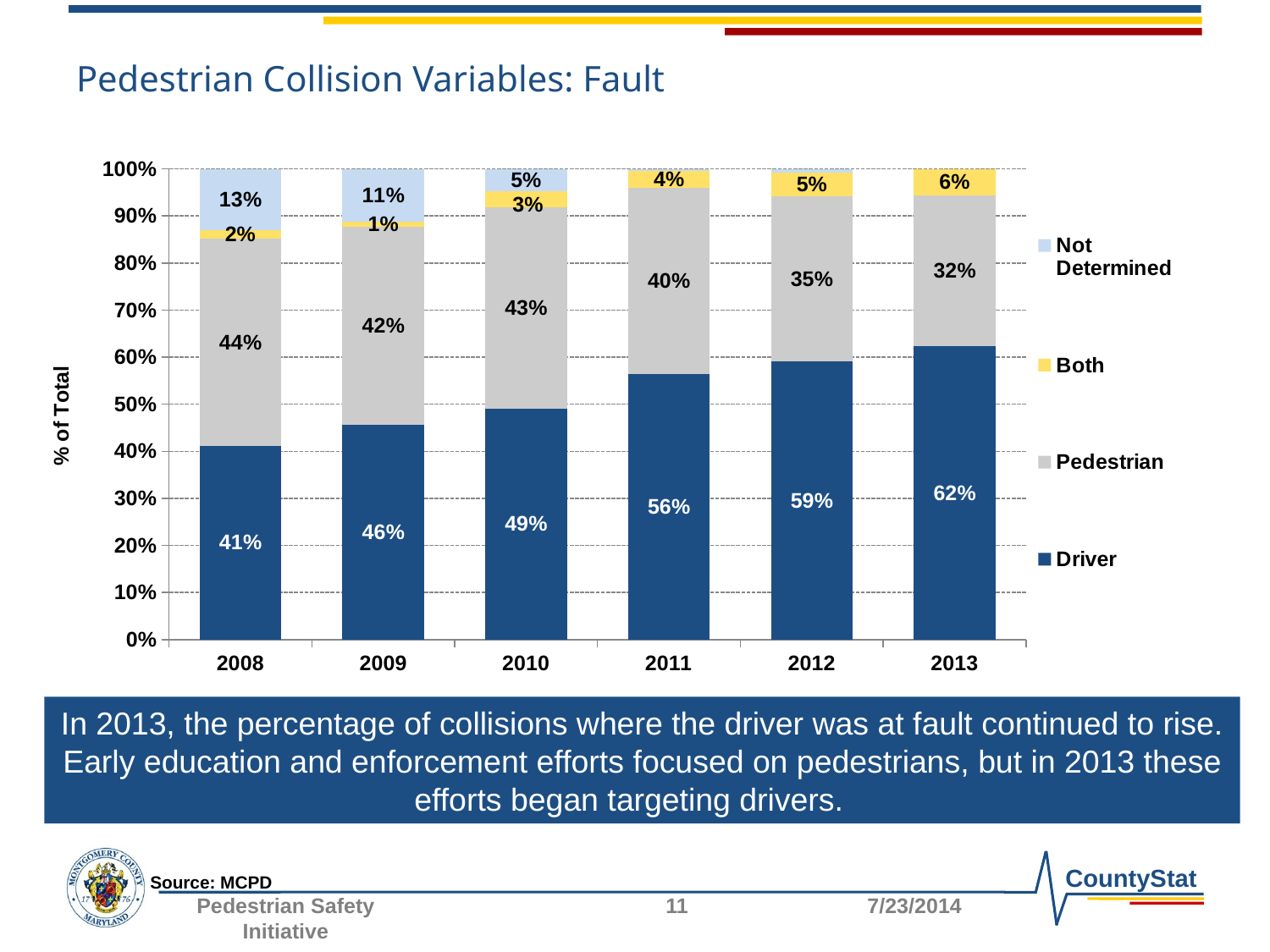
What kind of chart is shown on the slide? Stacked bar chart In which year is the Driver percentage highest? 2013 How many years are shown on the x axis? 6 What percentage of collisions in 2013 were the driver's fault? 62% In which year is the Pedestrian percentage lowest? 2013 Does the Driver percentage rise or fall from 2008 to 2013? Rise What is the Not Determined value for 2009? 11% What is the difference between the Driver percentage in 2013 and in 2008? 21% What is the Both value for 2010? 3% Which is larger in 2008, the Driver percentage or the Pedestrian percentage? Pedestrian How many series does the legend list? 4 What is the Pedestrian value for 2008? 44%